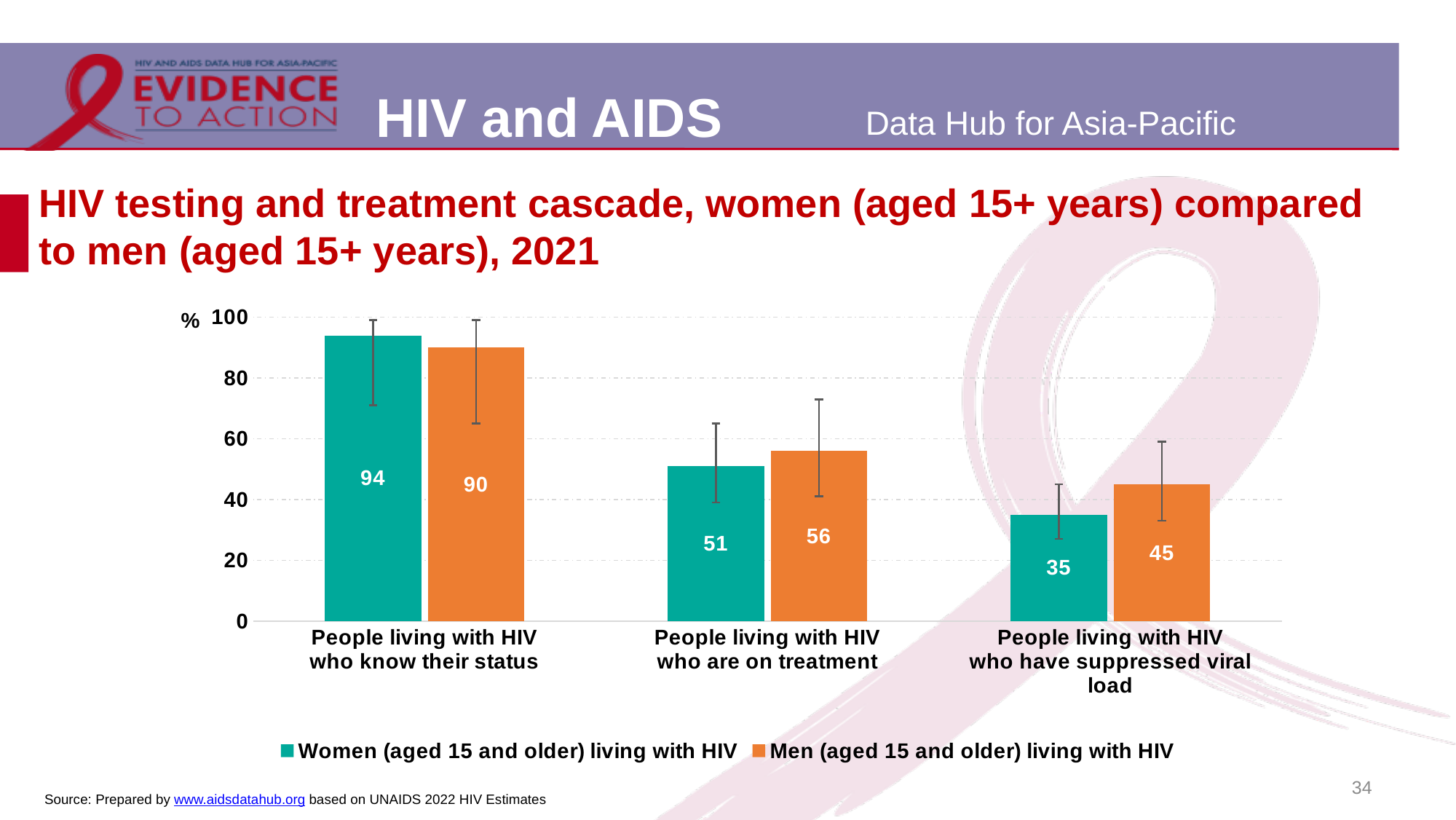
Do the values for women (aged 15 and older) living with HIV rise or fall across the categories from left to right? Fall Is the value for men (aged 15 and older) living with HIV who know their status greater or less than 80? greater What is the value for men (aged 15 and older) living with HIV who are on treatment? 56 What is the value for women (aged 15 and older) living with HIV who know their status? 94 For people living with HIV who are on treatment, which is larger: the value for women or for men? Men What is the value for women (aged 15 and older) living with HIV who have suppressed viral load? 35 How many categories are shown on the x axis? 3 Which category has the highest value for men (aged 15 and older) living with HIV? People living with HIV who know their status What kind of chart is shown on the slide? Bar chart How many series does the legend list? 2 What is the difference between the women and men values for people living with HIV who have suppressed viral load? 10 Which category has the lowest value for women (aged 15 and older) living with HIV? People living with HIV who have suppressed viral load